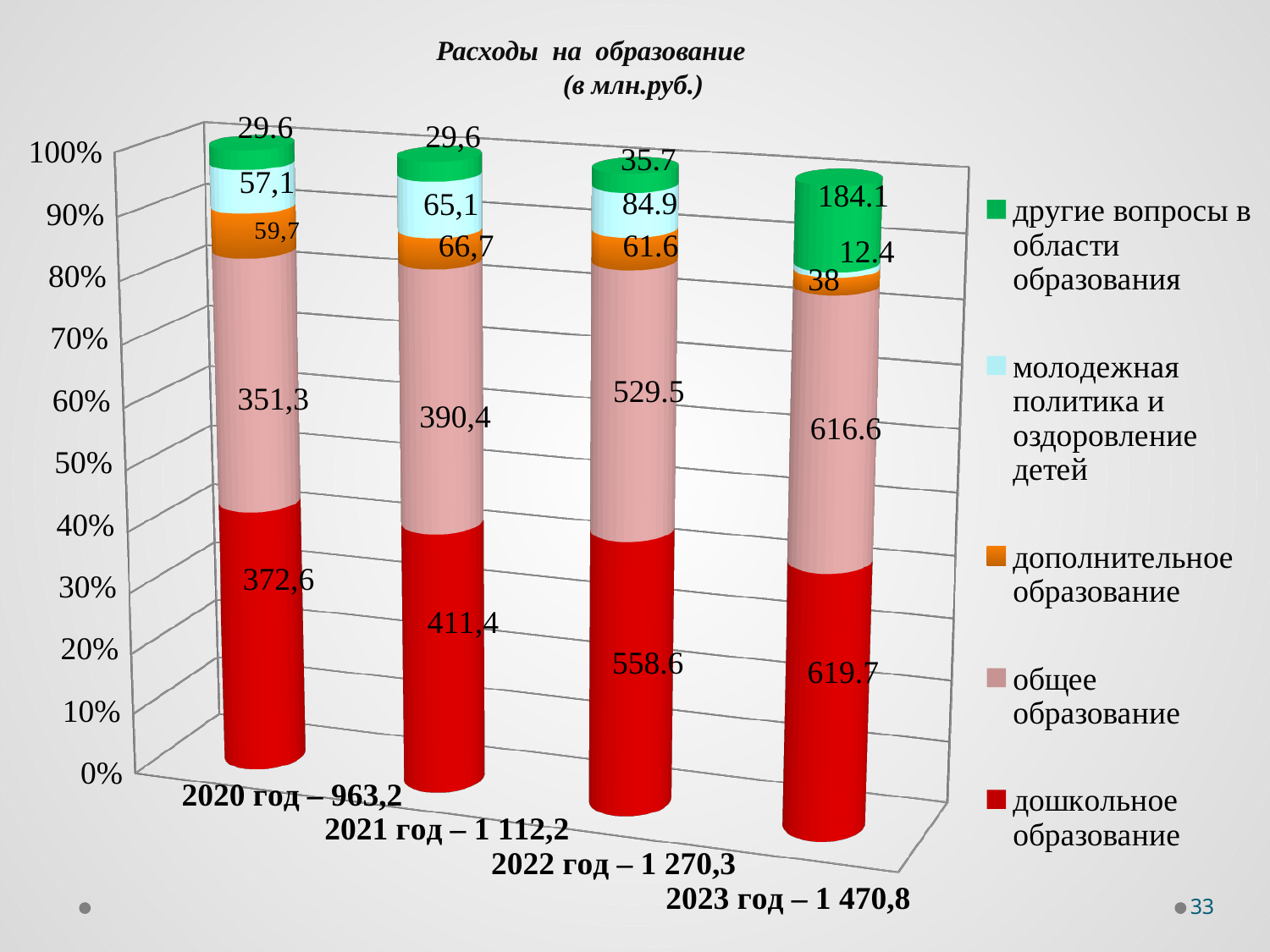
What is the value for другие вопросы в области образования in 2023? 184.1 In 2022, which is larger: молодежная политика и оздоровление детей or дополнительное образование? молодежная политика и оздоровление детей What is the value for молодежная политика и оздоровление детей in 2022? 84.9 What kind of chart is shown on the slide? stacked bar chart Does the value for дошкольное образование rise or fall from 2020 to 2023? rise What is the value for дошкольное образование in 2020? 372,6 How many series does the legend list? 5 In which year is the value for дошкольное образование the highest? 2023 What is the difference between дошкольное образование and общее образование in 2020? 21,3 What is the total expenditure for 2023 as shown on the slide? 1 470,8 In which year is the value for молодежная политика и оздоровление детей the lowest? 2023 How many years are shown on the x axis? 4